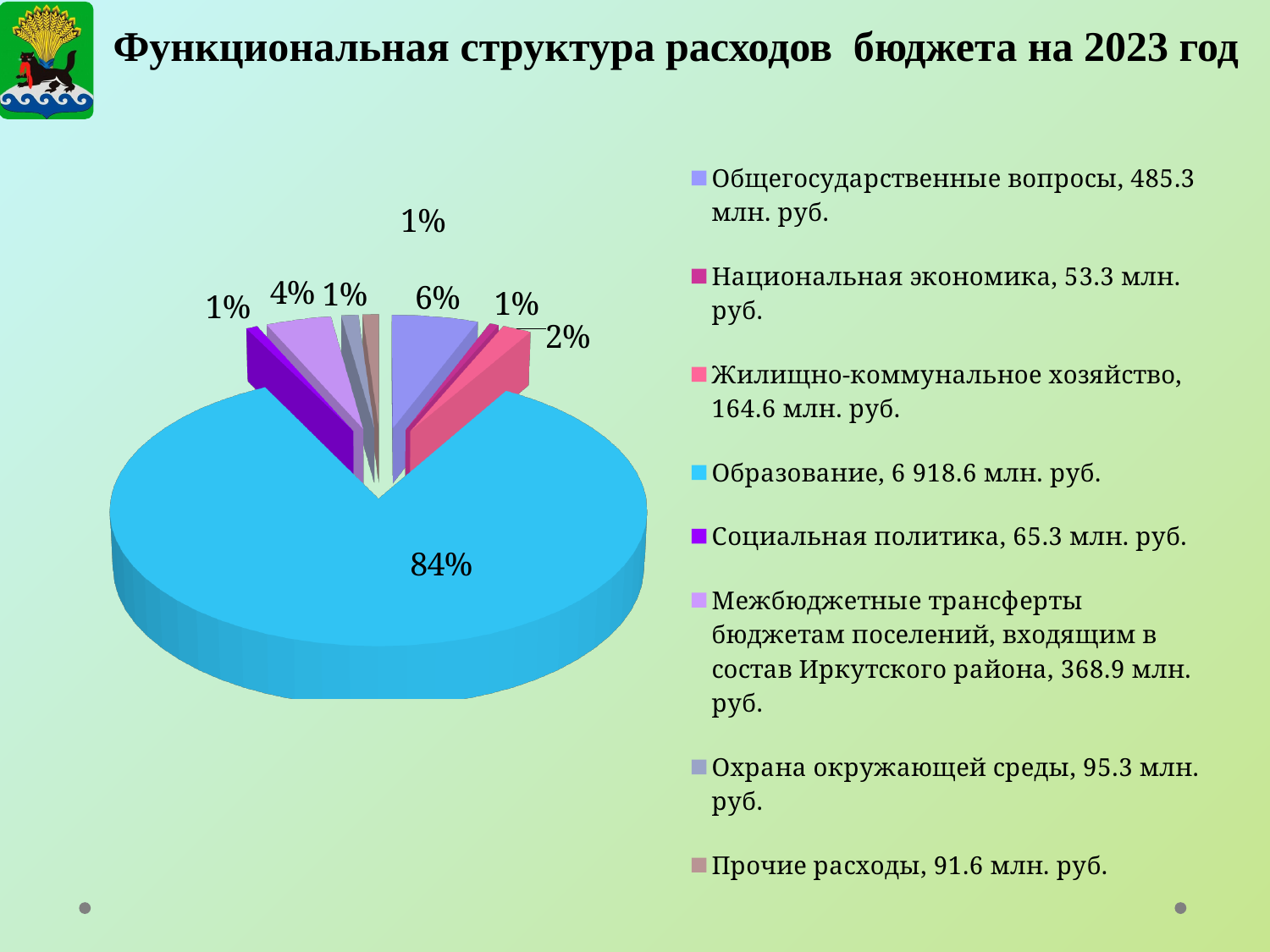
What type of chart is shown on the slide? Pie chart Which category has the largest value? Образование What is the difference between the values for Общегосударственные вопросы and Межбюджетные трансферты бюджетам поселений, входящим в состав Иркутского района? 116.4 млн. руб. Which is larger, the value for Социальная политика or the value for Прочие расходы? Прочие расходы What share of the pie does Межбюджетные трансферты бюджетам поселений, входящим в состав Иркутского района take? 4% What share of the pie does Образование take? 84% What share of the pie does Общегосударственные вопросы take? 6% What is the value for Охрана окружающей среды according to the legend? 95.3 млн. руб. What is the value for Жилищно-коммунальное хозяйство according to the legend? 164.6 млн. руб. How many categories does the pie chart have? 8 What is the value for Образование according to the legend? 6 918.6 млн. руб. Which category has the smallest value? Национальная экономика